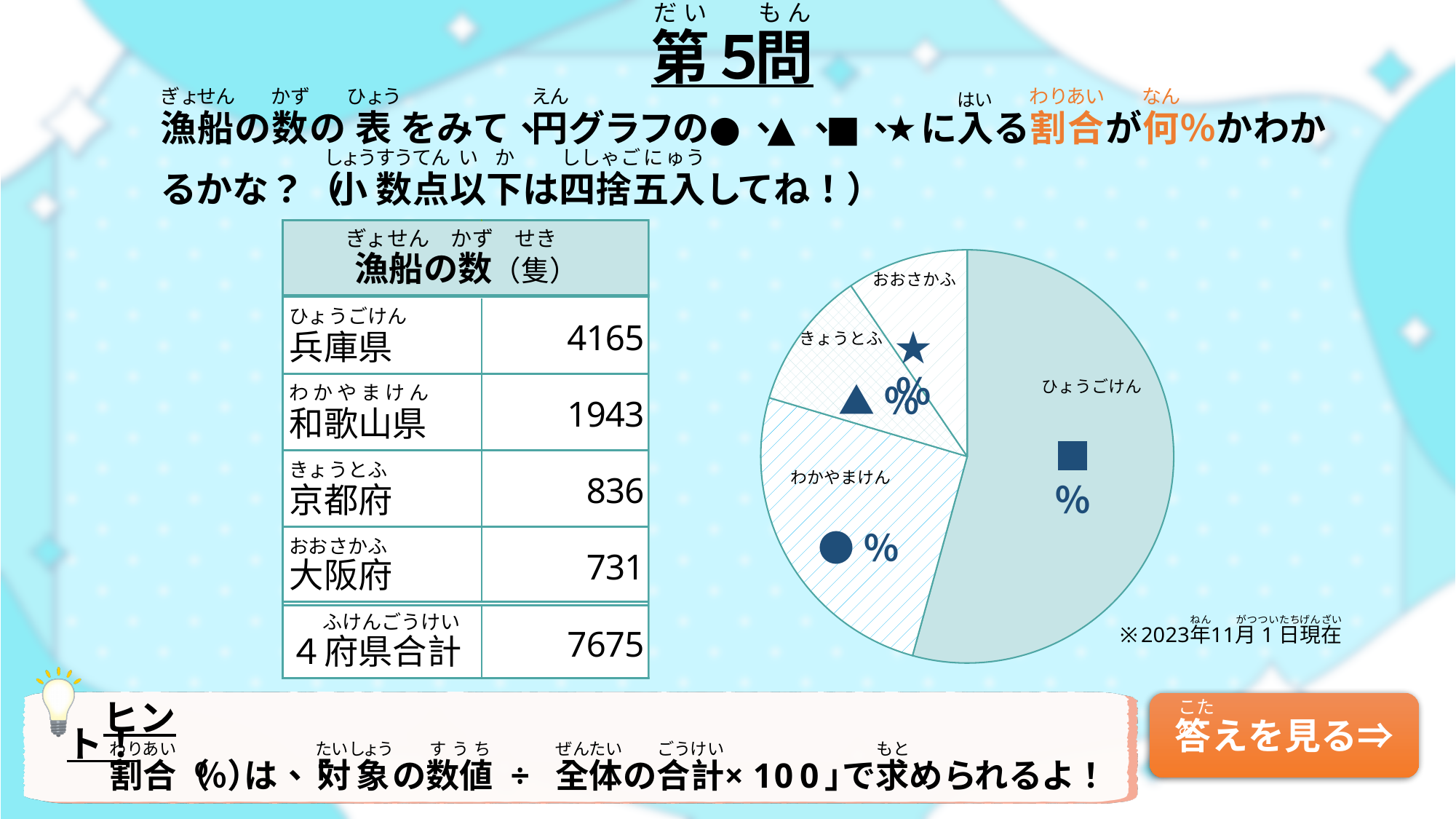
Which slice of the pie chart is larger, わかやまけん or きょうとふ? わかやまけん Using the table values, what is the share of ひょうごけん in the pie chart, rounded to a whole percent? 54% Which slice of the pie chart contains the ● symbol? わかやまけん Which slice of the pie chart is the largest? ひょうごけん Which slice of the pie chart is larger, ひょうごけん or わかやまけん? ひょうごけん Using the table values, what is the share of わかやまけん in the pie chart, rounded to a whole percent? 25% Which symbol is placed in the ひょうごけん slice of the pie chart? ■ What kind of chart is shown on the slide? pie chart How many slices does the pie chart have? 4 Using the table values, what is the share of おおさかふ in the pie chart, rounded to a whole percent? 10%